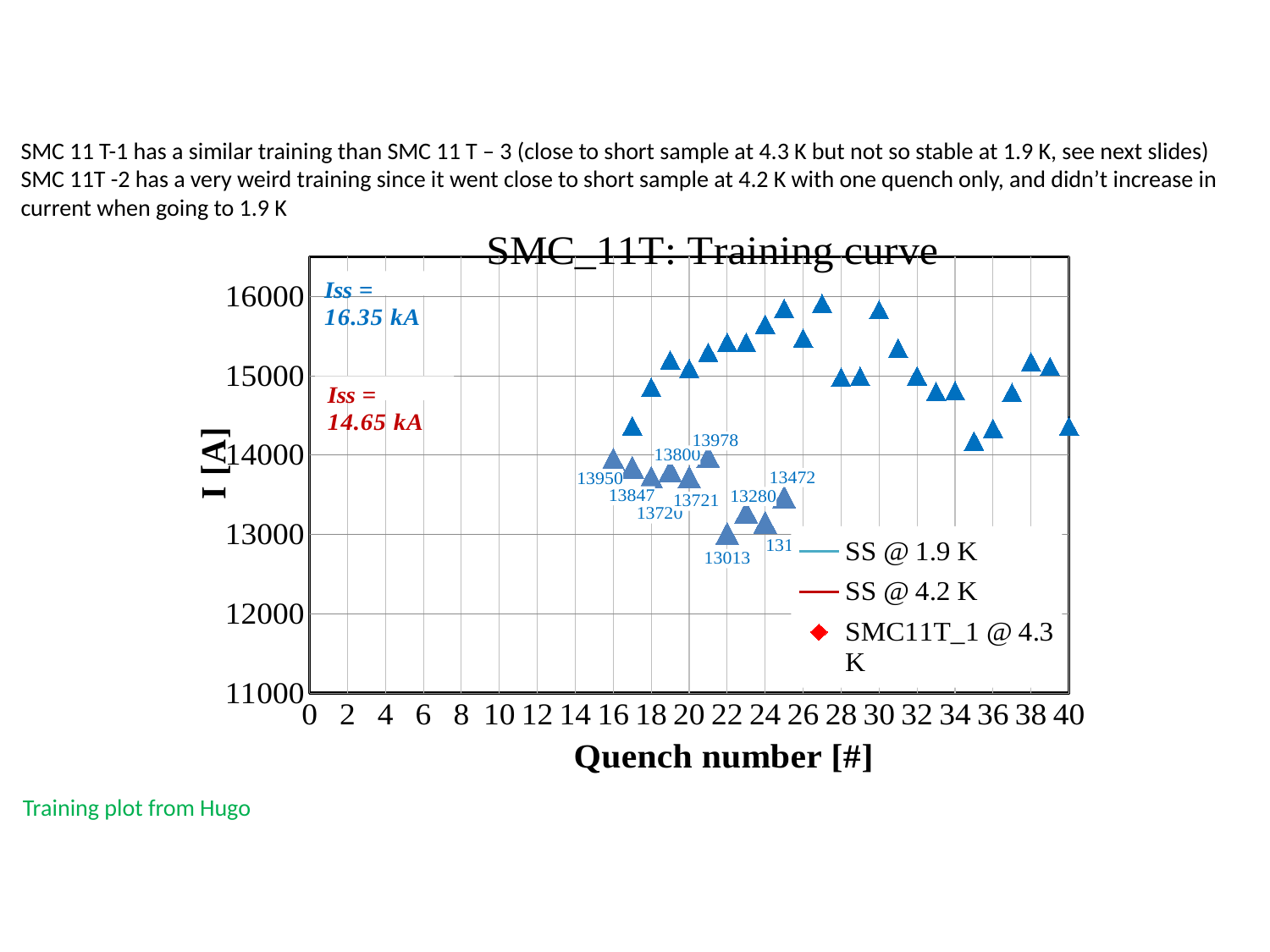
Is the value at quench number 35 greater or less than 15000? less Which is larger, the value at quench number 27 or the value at quench number 35? quench number 27 What is the highest data label value printed on the chart? 13978 Is the value at quench number 27 greater or less than 15000? greater What is the label of the x axis of the chart? Quench number [#] What kind of chart is shown on the slide? scatter chart What is the lowest data label value printed on the chart? 13013 What is the title of the chart? SMC_11T: Training curve How many entries does the chart legend list? 3 What Iss value is written in red on the chart? 14.65 kA What Iss value is written in blue on the chart? 16.35 kA